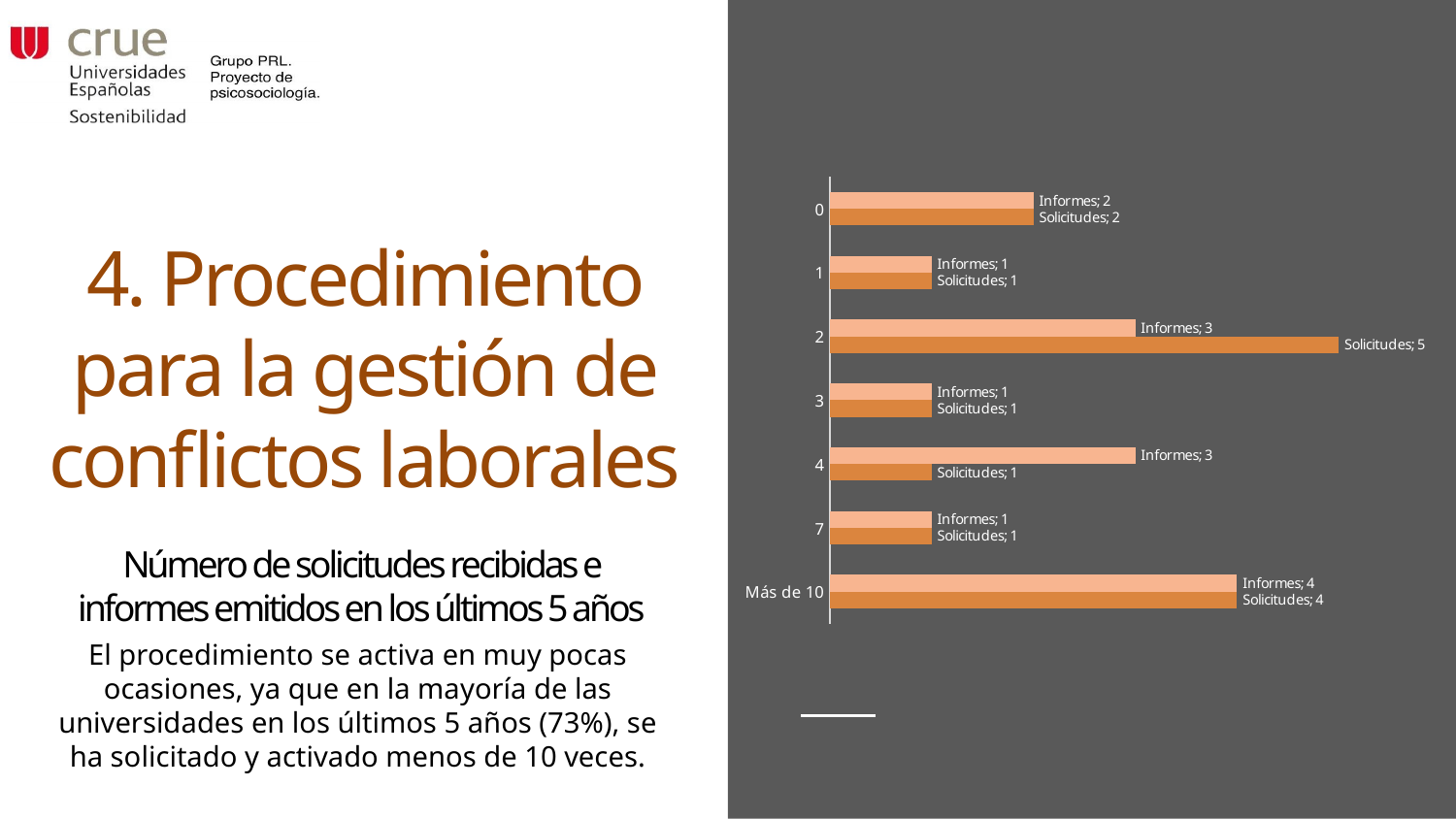
What is the Solicitudes value for category 0? 2 How many categories are shown on the chart? 7 What type of chart is shown on the slide? Bar chart Which category has the highest Informes value? Más de 10 What is the Solicitudes value for category 2? 5 How many data series are plotted on the chart? 2 For category 4, which is larger: Informes or Solicitudes? Informes What is the difference between the Informes values for category 2 and category 1? 2 What is the difference between Solicitudes and Informes for category 2? 2 What is the Informes value for the category 'Más de 10'? 4 Which category has the highest Solicitudes value? 2 What is the Informes value for category 4? 3